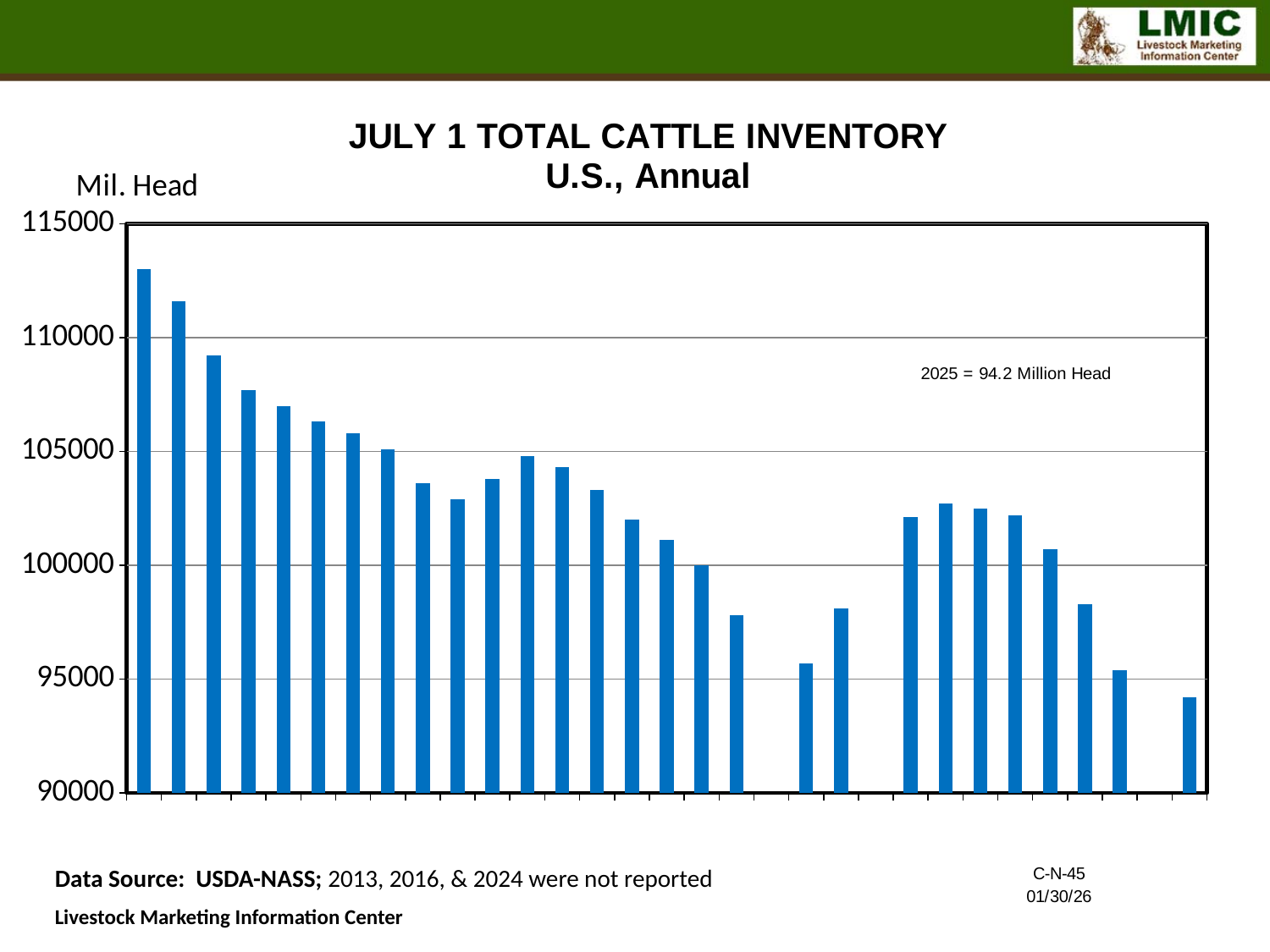
Which is larger, the leftmost bar or the rightmost bar? The leftmost bar Is the value of the second bar from the left greater or less than 110000? greater Which bar is the highest on the chart, the leftmost or the rightmost? The leftmost Is the value of the last (rightmost) bar greater or less than 95000? less Is the value of the first (leftmost) bar greater or less than 110000? greater Overall, do the values rise or fall from left to right across the chart? Fall What is the title of the chart? JULY 1 TOTAL CATTLE INVENTORY U.S., Annual Which bar is the lowest on the chart, the leftmost or the rightmost? The rightmost According to the annotation on the chart, what was the July 1 total cattle inventory in 2025? 94.2 Million Head What kind of chart is shown on the slide? Bar chart Which years does the slide say were not reported? 2013, 2016, & 2024 What is the lowest value shown on the vertical axis? 90000